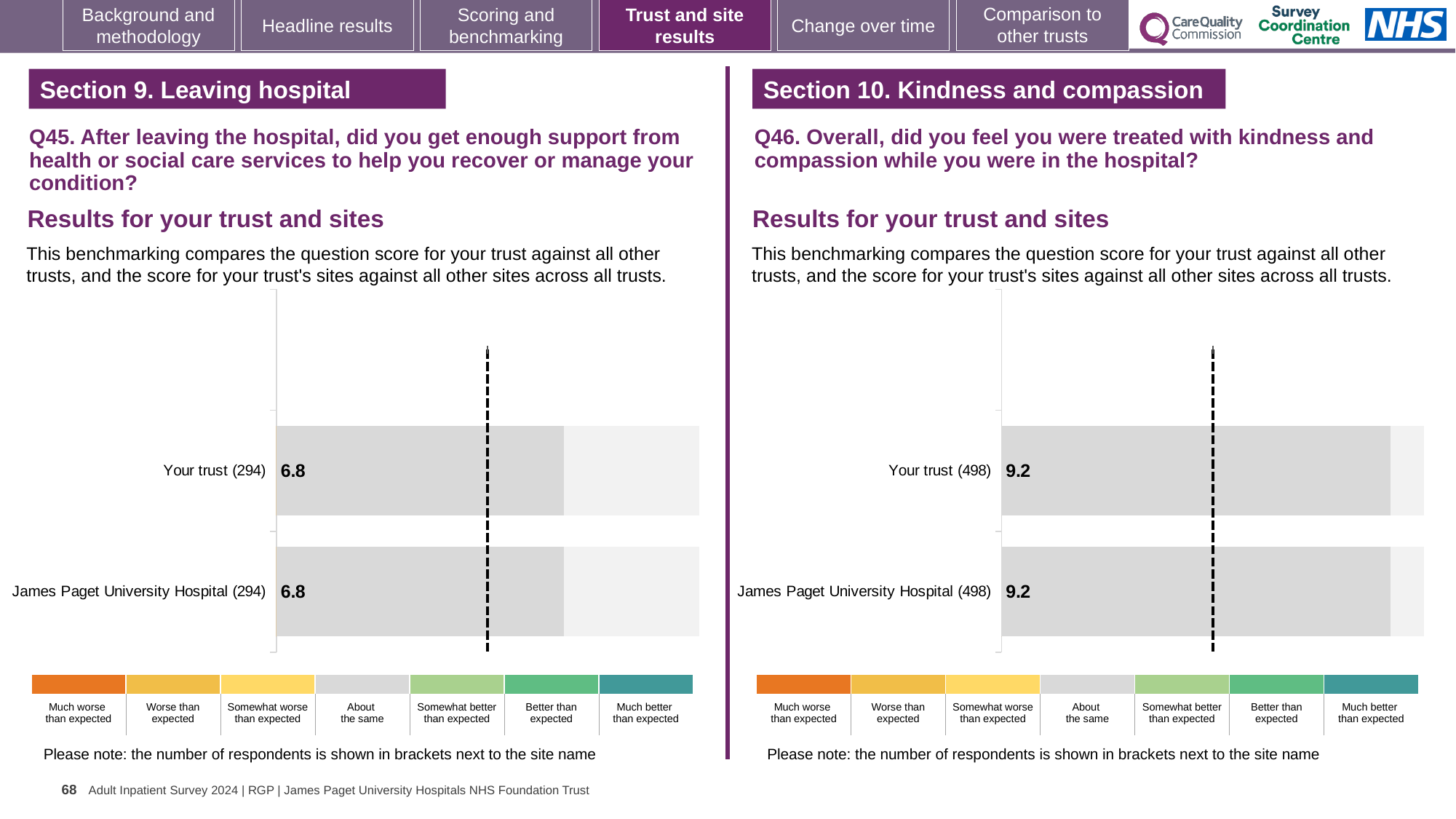
On the Q46 chart (right), what is the score for James Paget University Hospital? 9.2 What is the difference between the Your trust score on the Q46 chart (right) and the Your trust score on the Q45 chart (left)? 2.4 How many bars are plotted on the Q45 chart (left)? 2 On the Q46 chart (right), how many respondents are shown in brackets for James Paget University Hospital? 498 In the colour key below the Q46 chart (right), what colour represents 'Much worse than expected'? Orange What kind of chart is used on the Q46 chart (right)? Bar chart On the Q45 chart (left), how many respondents are shown in brackets for Your trust? 294 On the Q45 chart (left), what is the score for Your trust? 6.8 On the Q46 chart (right), what is the score for Your trust? 9.2 How many benchmark categories are listed in the colour key below the Q45 chart (left)? 7 Which is larger: the James Paget University Hospital score on the Q46 chart (right) or on the Q45 chart (left)? Q46 chart (right) On the Q45 chart (left), what is the score for James Paget University Hospital? 6.8